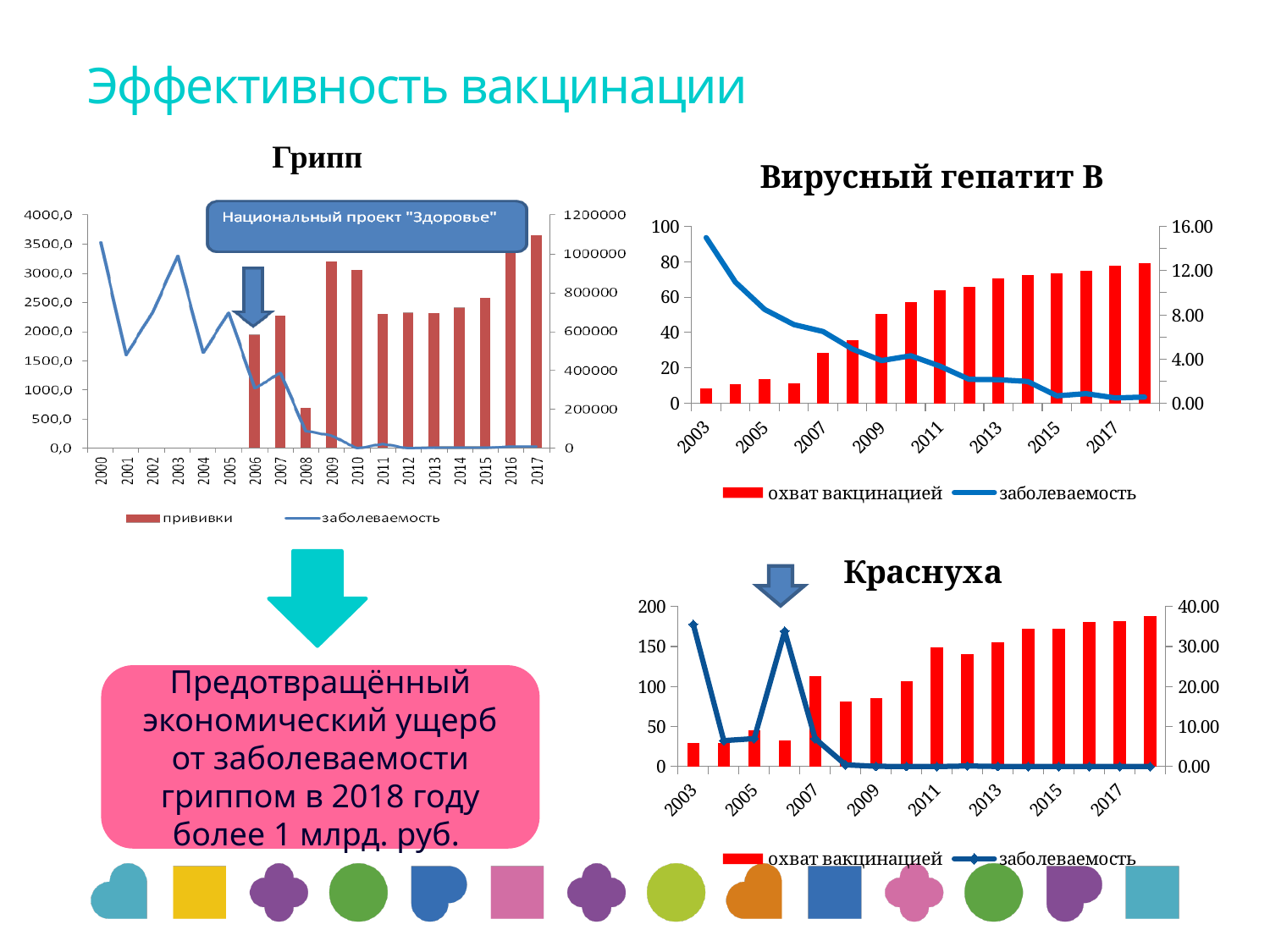
In the 'Краснуха' chart, is the 'охват вакцинацией' bar for 2018 greater or less than 150 on the left axis? greater How many series does the legend of the 'Краснуха' chart list? 2 In the 'Вирусный гепатит В' chart, is the 'охват вакцинацией' bar for 2003 greater or less than 20 on the left axis? less In the 'Вирусный гепатит В' chart, which year has the shortest bar for 'охват вакцинацией'? 2003 What kind of chart is the 'Грипп' chart? bar and line chart In the 'Краснуха' chart, which bar is taller: 2010 or 2011? 2011 In the 'Вирусный гепатит В' chart, is the 'охват вакцинацией' bar for 2018 greater or less than 60 on the left axis? greater In the 'Вирусный гепатит В' chart, which year has the tallest bar for 'охват вакцинацией'? 2018 In the 'Вирусный гепатит В' chart, does the 'заболеваемость' line rise or fall from 2003 to 2018? fall In the 'Краснуха' chart, which year has the tallest bar for 'охват вакцинацией'? 2018 How many years are shown on the x axis of the 'Грипп' chart? 18